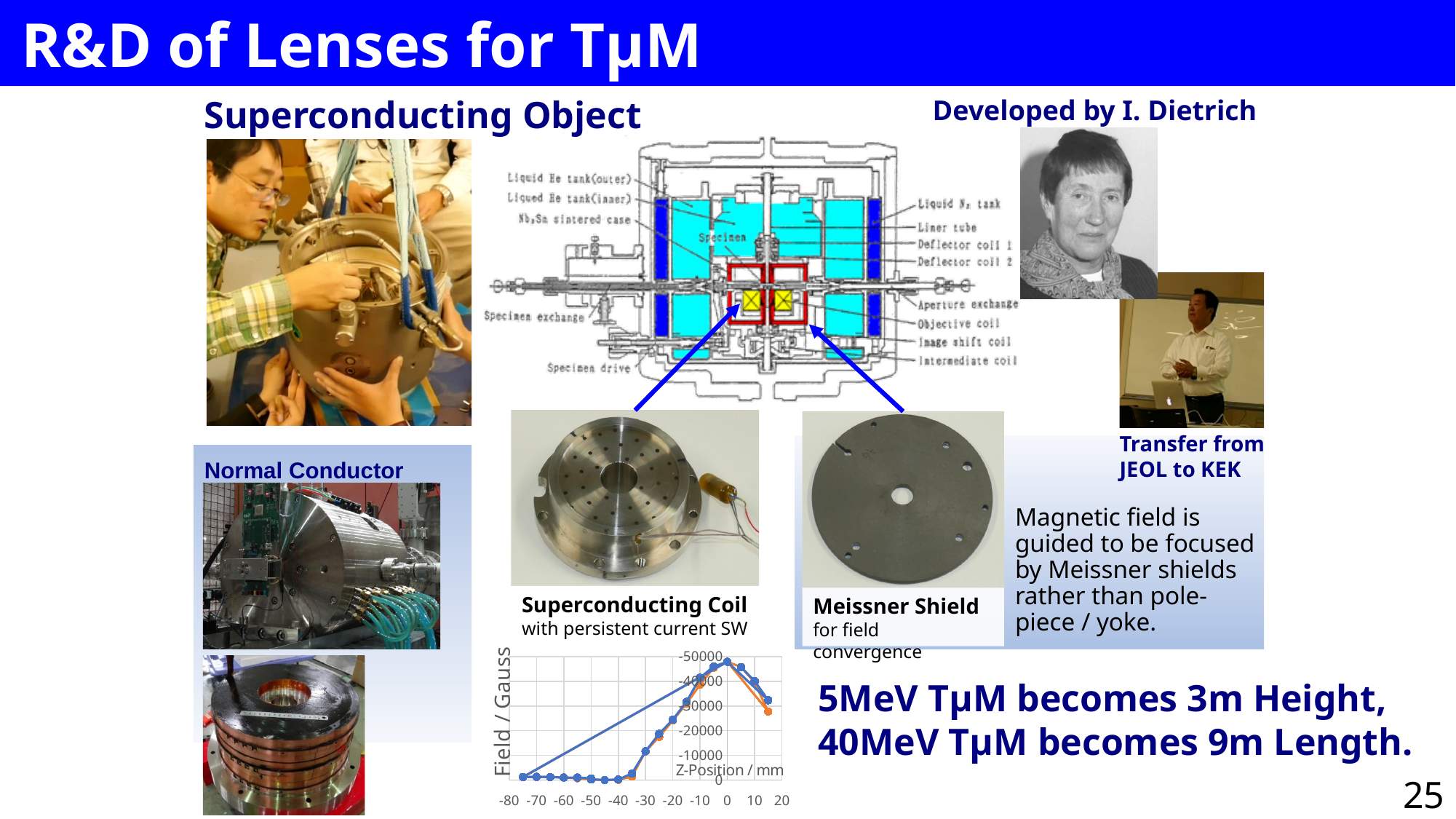
What is the label of the vertical axis of the chart? Field / Gauss Is the field value at Z-Position 0 mm greater or less than -40000? less What is the leftmost tick label on the horizontal axis of the chart? -80 What is the label of the horizontal axis of the chart? Z-Position / mm At which Z-Position does the field reach its most negative value on the chart? 0 How many tick labels are shown on the horizontal axis of the chart? 11 Is the field value at Z-Position -60 mm greater or less than -10000? greater How many lines (series) are plotted on the chart? 2 What kind of chart is shown at the bottom of the slide? line chart Between Z-Position -40 mm and 0 mm, does the field value increase or decrease? decrease